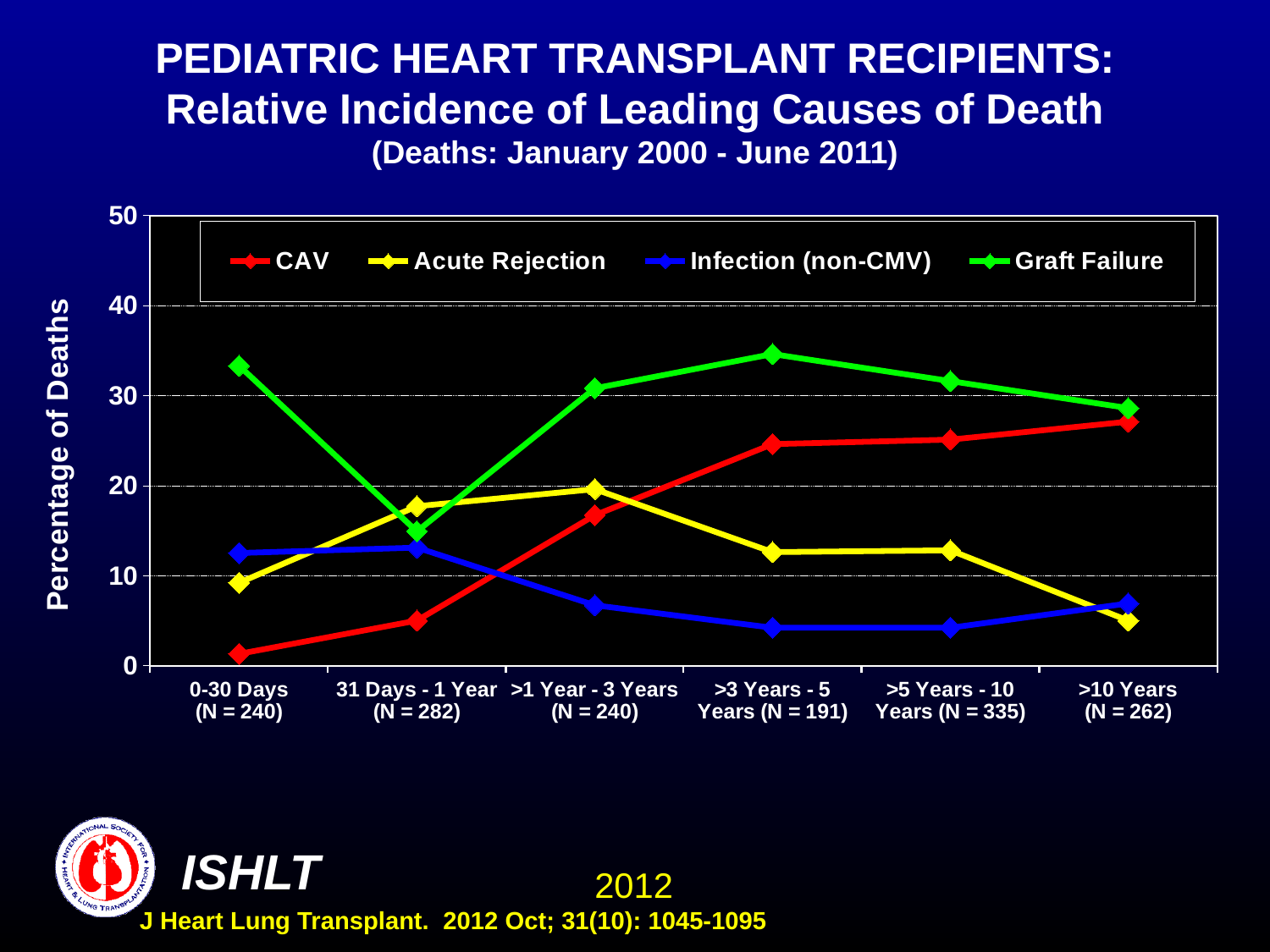
What is the y-axis title of the chart? Percentage of Deaths Is the Infection (non-CMV) value for >3 Years - 5 Years greater or less than 10? less How many series does the legend list? 4 Does the CAV line generally rise or fall across the time periods from left to right? rise What kind of chart is shown on the slide? line chart Which cause of death has the lowest percentage at 0-30 Days? CAV Which cause of death has the highest percentage at >3 Years - 5 Years? Graft Failure How many time-period categories are shown on the x axis? 6 In which time period is the Graft Failure percentage lowest? 31 Days - 1 Year At >10 Years, which is larger: CAV or Acute Rejection? CAV Is the Graft Failure value for 0-30 Days greater or less than 30? greater Is the CAV value for 0-30 Days greater or less than 10? less